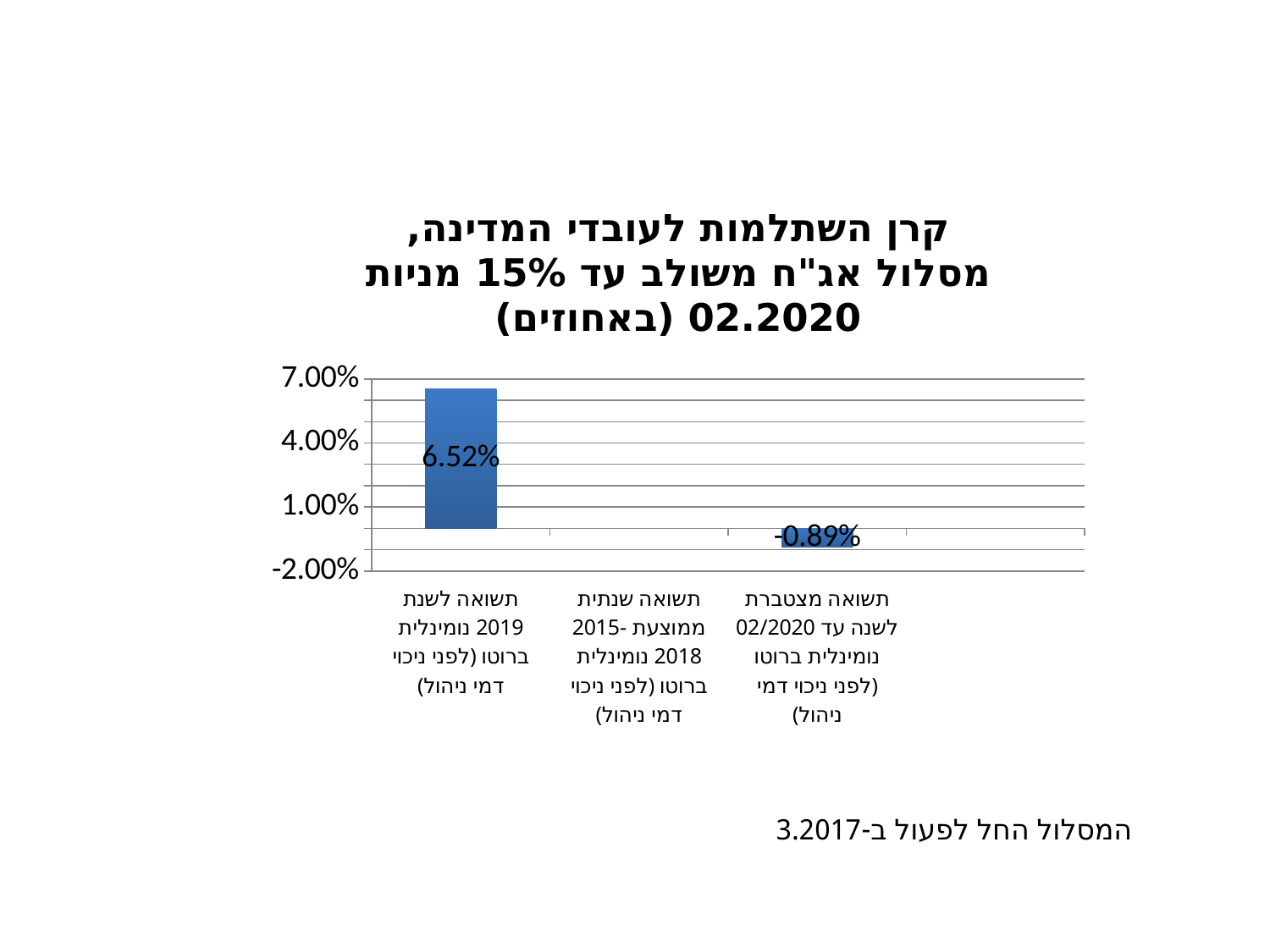
What is the difference between the 2019 return (6.52%) and the cumulative return to 02/2020 (-0.89%)? 7.41 percentage points Is the value for 'תשואה מצטברת לשנה עד 02/2020' greater or less than 1.00%? less What is the value for 'תשואה מצטברת לשנה עד 02/2020 נומינלית ברוטו (לפני ניכוי דמי ניהול)'? -0.89% Which category has no bar plotted? תשואה שנתית ממוצעת 2015-2018 נומינלית ברוטו (לפני ניכוי דמי ניהול) What kind of chart is shown on the slide? Bar chart How many categories are shown on the x axis? 3 Is the value for 'תשואה לשנת 2019 נומינלית ברוטו' greater or less than 4.00%? greater Which is larger: the return for 2019 or the cumulative return to 02/2020? The return for 2019 What is the title of the chart? קרן השתלמות לעובדי המדינה, מסלול אג"ח משולב עד 15% מניות 02.2020 (באחוזים) Which category has the highest value? תשואה לשנת 2019 נומינלית ברוטו (לפני ניכוי דמי ניהול) Which category with a plotted bar has the lowest value? תשואה מצטברת לשנה עד 02/2020 נומינלית ברוטו (לפני ניכוי דמי ניהול) What is the value for 'תשואה לשנת 2019 נומינלית ברוטו (לפני ניכוי דמי ניהול)'? 6.52%